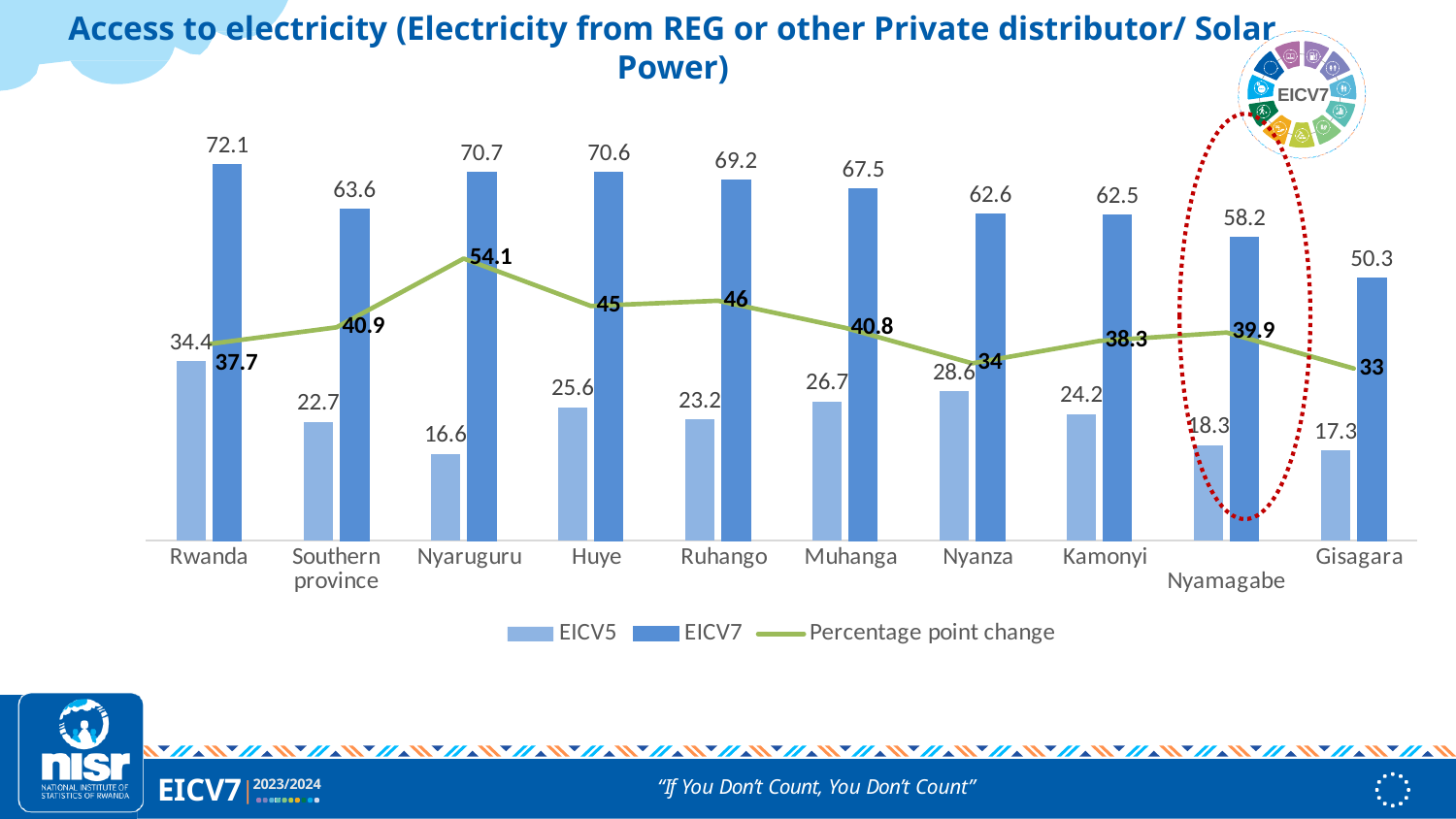
What is the EICV5 value for Nyamagabe? 18.3 How many categories are shown on the x axis? 10 Which category has the lowest EICV7 value? Gisagara How many series does the legend list? 3 Which series is shown as a green line? Percentage point change What is the percentage point change for Huye? 45 What kind of chart is shown on the slide? Bar chart with a line What is the EICV7 value for Nyaruguru? 70.7 What is the difference between the EICV7 and EICV5 values for Rwanda? 37.7 Which category has the lowest EICV5 value? Nyaruguru Which category has the highest percentage point change? Nyaruguru Which is larger, the EICV7 value for Muhanga or the EICV7 value for Nyanza? Muhanga